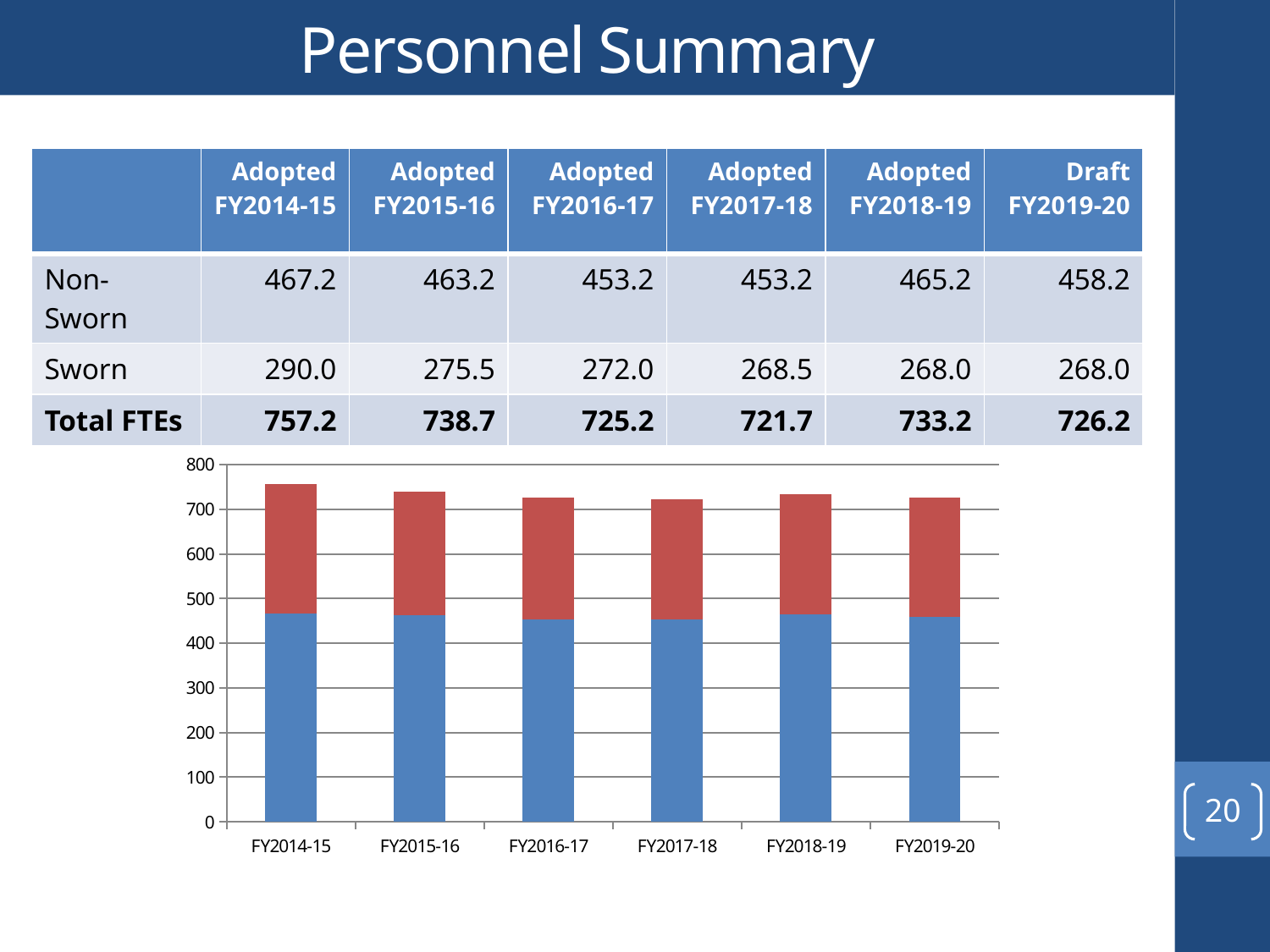
What is the Total FTEs value for FY2014-15? 757.2 What is the highest value shown on the chart's vertical axis? 800 What is the Sworn value for FY2019-20? 268.0 Is the total bar for FY2014-15 greater or less than 700? greater Do the Total FTEs values rise or fall from FY2014-15 to FY2017-18? fall What is the Non-Sworn value for FY2018-19? 465.2 Which fiscal year has the highest Total FTEs bar? FY2014-15 What is the difference between Total FTEs in FY2014-15 and FY2019-20? 31.0 How many fiscal years are shown on the x axis of the chart? 6 What is the total of the stacked bar for FY2017-18? 721.7 What kind of chart is shown on the slide? Stacked bar chart Which is larger, the Total FTEs bar for FY2014-15 or for FY2019-20? FY2014-15